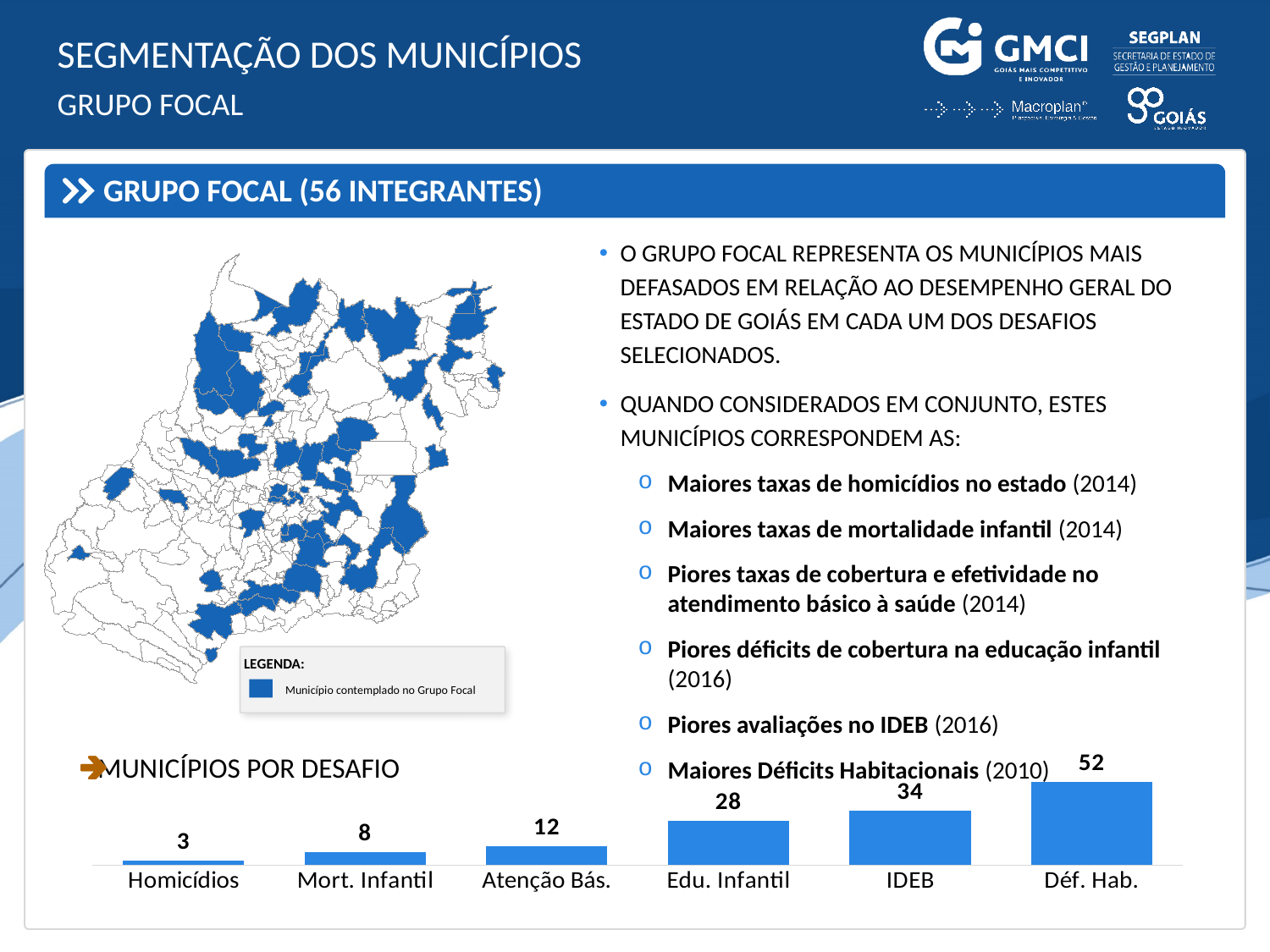
In the 'Municípios por Desafio' chart, which is larger: Edu. Infantil or Atenção Bás.? Edu. Infantil In the 'Municípios por Desafio' chart, which category has the lowest value? Homicídios In the 'Municípios por Desafio' chart, what is the value for IDEB? 34 What kind of chart is 'Municípios por Desafio'? Bar chart In the 'Municípios por Desafio' chart, what is the value for Edu. Infantil? 28 In the 'Municípios por Desafio' chart, what is the difference between Atenção Bás. and Mort. Infantil? 4 How many categories are shown in the 'Municípios por Desafio' chart? 6 In the 'Municípios por Desafio' chart, what is the value for Homicídios? 3 In the 'Municípios por Desafio' chart, which category has the highest value? Déf. Hab. In the 'Municípios por Desafio' chart, what is the difference between Déf. Hab. and IDEB? 18 In the 'Municípios por Desafio' chart, do the values rise or fall from left to right? Rise What is the title of the bar chart at the bottom of the slide? Municípios por Desafio